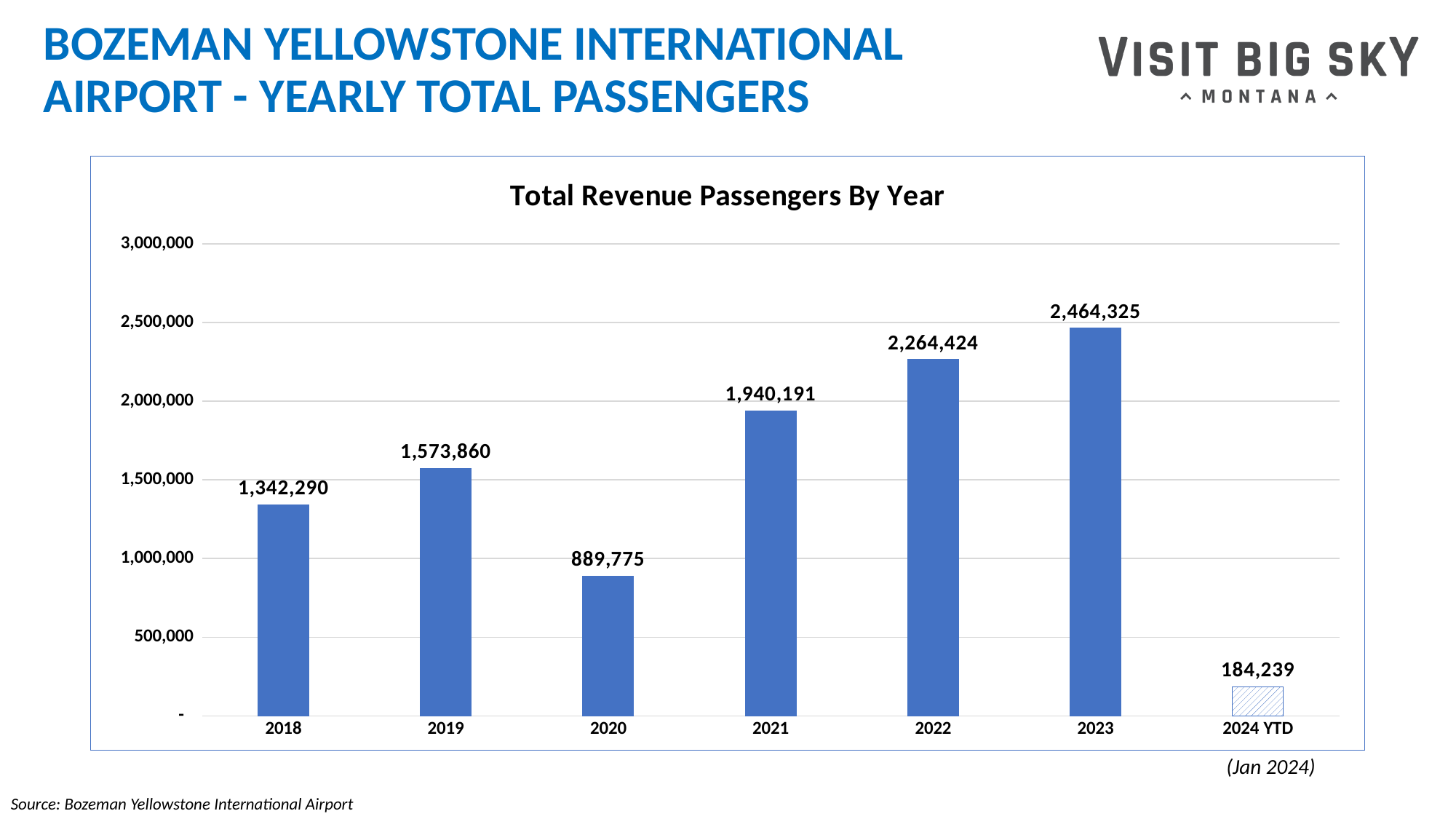
Which category has the lowest value in the chart? 2024 YTD What is the value shown for 2024 YTD? 184,239 How many total revenue passengers are shown for 2020? 889,775 What is the difference between the 2023 and 2022 values? 199,901 Is the value for 2022 greater or less than 2,000,000? greater How many bars are plotted in the chart? 7 Which year has the highest number of total revenue passengers? 2023 What is the title of the chart? Total Revenue Passengers By Year By how much did total revenue passengers increase from 2020 to 2021? 1,050,416 What is the value for 2023 in the Total Revenue Passengers By Year chart? 2,464,325 Which is larger, the value for 2019 or the value for 2021? 2021 What kind of chart is shown on the slide? Bar chart